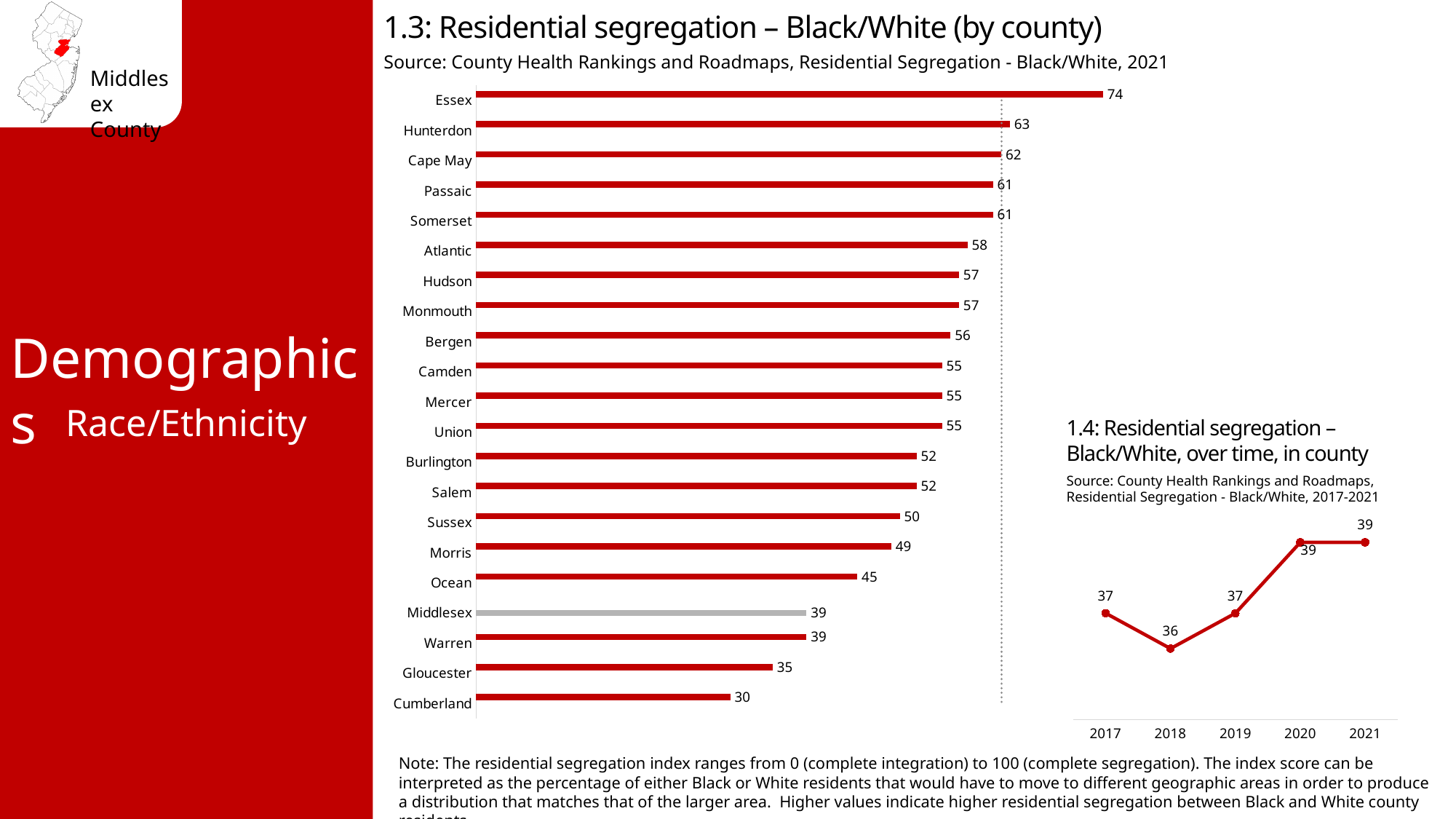
In the chart '1.3: Residential segregation – Black/White (by county)', which county has the highest value? Essex In the chart '1.4: Residential segregation – Black/White, over time, in county', what is the value for 2018? 36 In the chart '1.3: Residential segregation – Black/White (by county)', what is the value for Essex? 74 How many counties are shown in the chart '1.3: Residential segregation – Black/White (by county)'? 21 What kind of chart is '1.3: Residential segregation – Black/White (by county)'? Bar chart In the chart '1.4: Residential segregation – Black/White, over time, in county', which year has the lowest value? 2018 In the chart '1.4: Residential segregation – Black/White, over time, in county', what is the difference between the values for 2021 and 2017? 2 In the chart '1.3: Residential segregation – Black/White (by county)', which has a larger value, Atlantic or Ocean? Atlantic In the chart '1.3: Residential segregation – Black/White (by county)', what is the difference between the values for Essex and Cumberland? 44 In the chart '1.3: Residential segregation – Black/White (by county)', what is the value for Middlesex? 39 In the chart '1.3: Residential segregation – Black/White (by county)', which county has the lowest value? Cumberland What kind of chart is '1.4: Residential segregation – Black/White, over time, in county'? Line chart